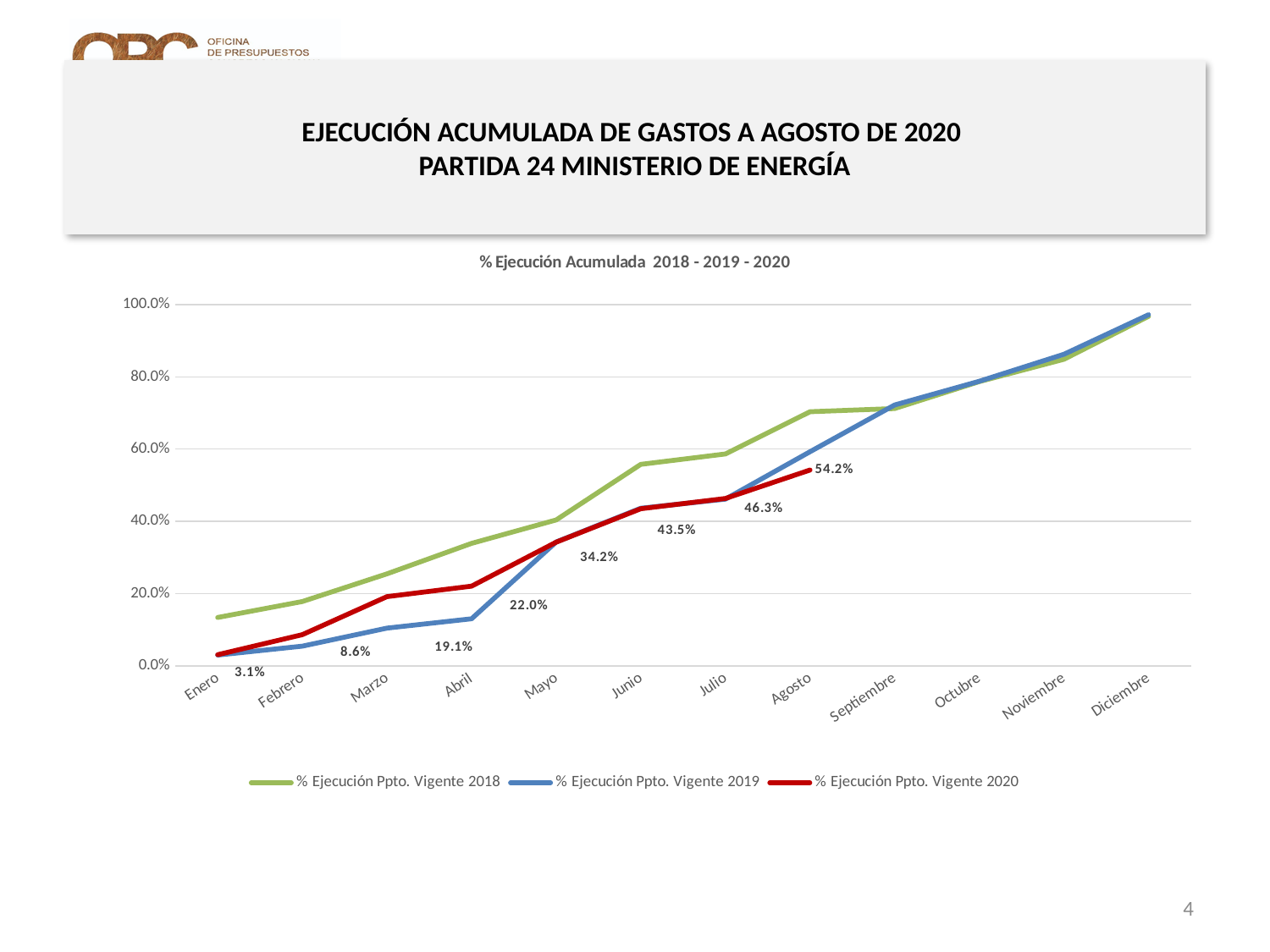
Is the value for % Ejecución Ppto. Vigente 2018 in Agosto greater or less than 60.0%? greater What kind of chart is shown on the slide? line chart What is the value for % Ejecución Ppto. Vigente 2020 in Marzo? 19.1% What is the difference between the % Ejecución Ppto. Vigente 2020 values for Agosto and Julio? 7.9% What is the value for % Ejecución Ppto. Vigente 2020 in Mayo? 34.2% Does the % Ejecución Ppto. Vigente 2020 line rise or fall from Enero to Agosto? rise What is the value for % Ejecución Ppto. Vigente 2020 in Enero? 3.1% How many series does the legend list? 3 Which series has the highest value in Agosto? % Ejecución Ppto. Vigente 2018 What is the difference between the % Ejecución Ppto. Vigente 2020 values for Junio and Abril? 21.5% How many months are shown on the x axis? 12 What is the value for % Ejecución Ppto. Vigente 2020 in Agosto? 54.2%